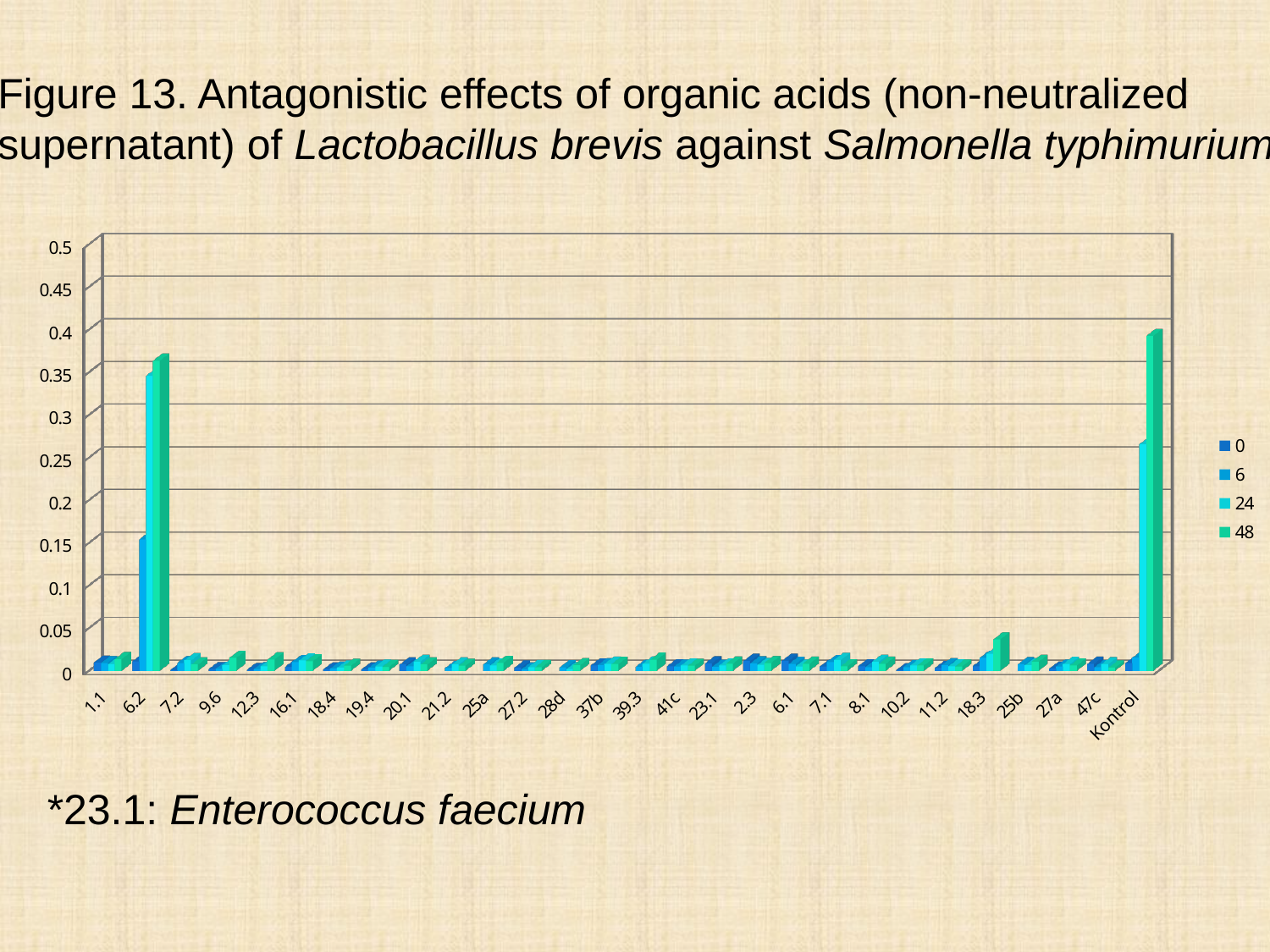
Is the value for 6.2 in the 48 series greater or less than 0.3? greater Which is larger for the 48 series: the value for Kontrol or the value for 6.2? Kontrol What are the series names listed in the legend? 0, 6, 24, 48 How many categories are shown along the x axis? 28 Is the value for Kontrol in the 48 series greater or less than 0.35? greater Is the value for Kontrol in the 24 series greater or less than 0.2? greater Which category has the highest value for the 48 series? Kontrol What kind of chart is shown on the slide? bar chart How many series does the legend list? 4 What is the label of the last category on the x axis? Kontrol Which is larger for the 48 series: the value for 6.2 or the value for 18.3? 6.2